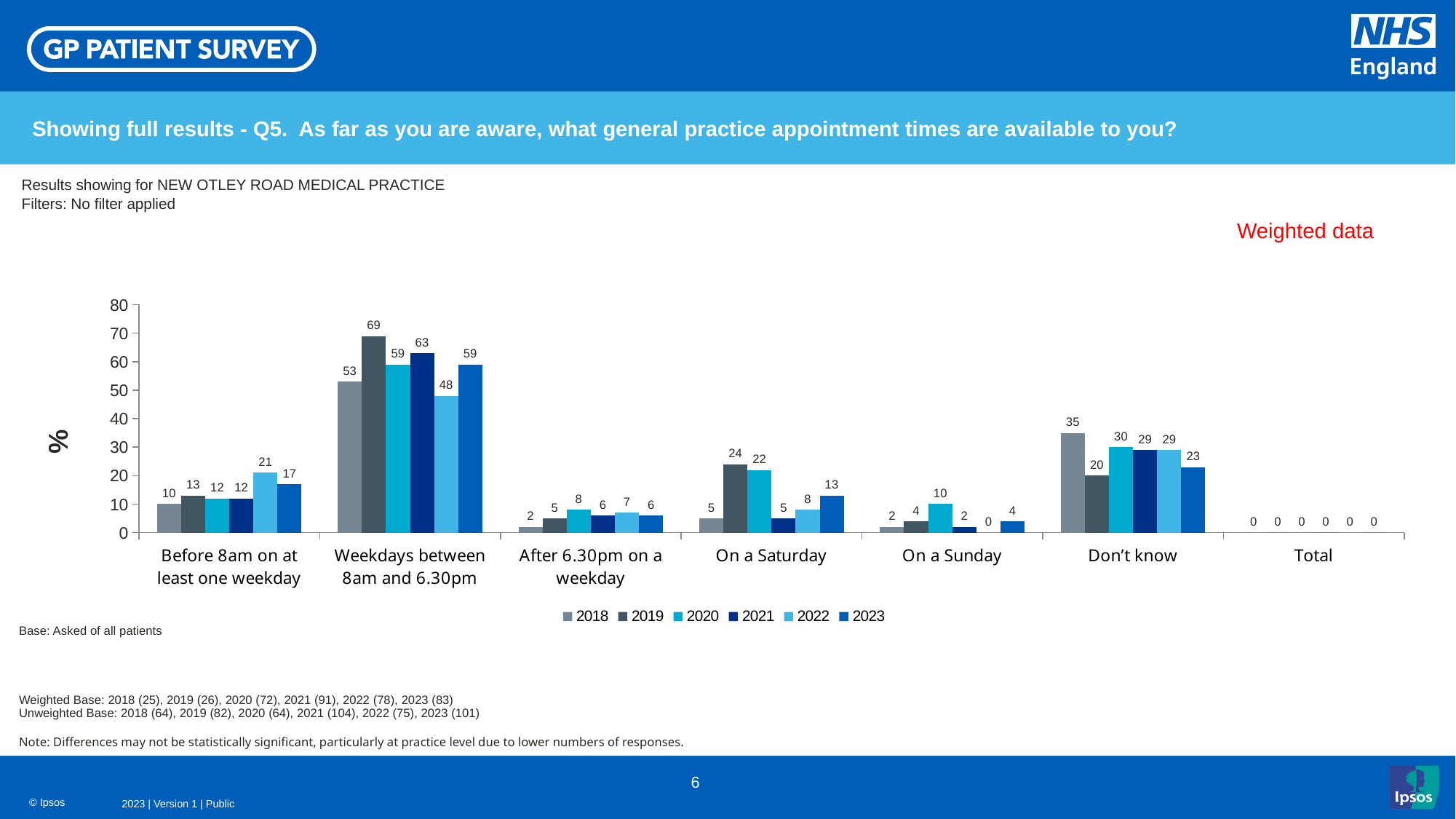
Which is larger for 'On a Sunday': the 2020 value or the 2023 value? 2020 How many series does the legend list? 6 What is the 2018 value for 'Don't know'? 35 Which year has the lowest value for 'Weekdays between 8am and 6.30pm'? 2022 What is the 2019 value for 'Weekdays between 8am and 6.30pm'? 69 What kind of chart is shown on the slide? Bar chart What label is shown on the y axis of the chart? % What is the difference between the 2019 and 2018 values for 'Weekdays between 8am and 6.30pm'? 16 Which year has the highest value for 'On a Saturday'? 2019 What is the 2022 value for 'Before 8am on at least one weekday'? 21 What is the 2023 value for 'After 6.30pm on a weekday'? 6 How many categories are shown on the x axis? 7